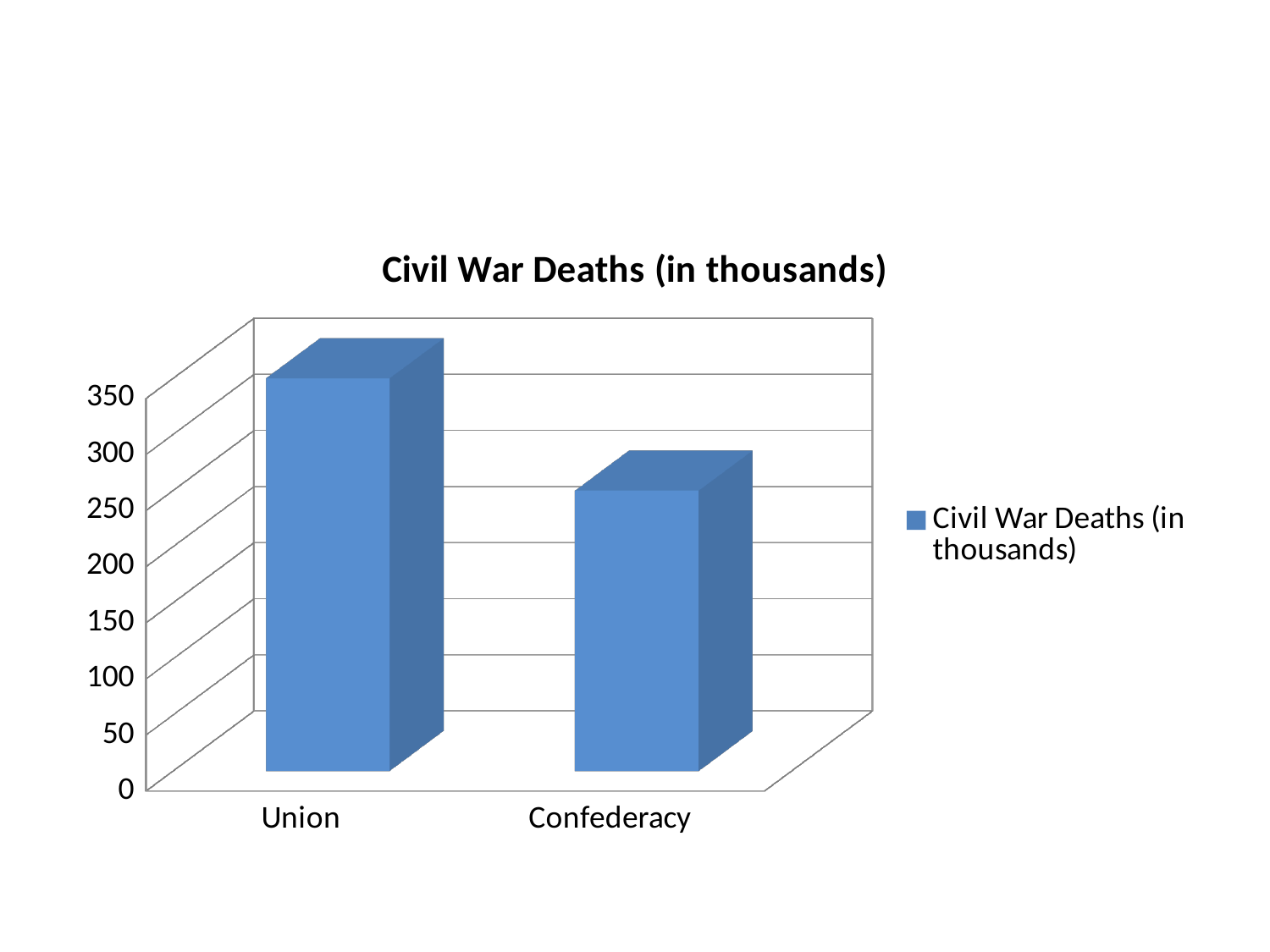
Which is larger, the value for Union or the value for Confederacy? Union How many categories are plotted on the x axis of the chart? 2 How many series does the legend list? 1 Which category has the lowest value in the chart? Confederacy Is the value for Confederacy greater or less than 200? greater Which category has the highest value in the chart? Union What is the title of the chart? Civil War Deaths (in thousands) What kind of chart is shown on the slide? Bar chart Is the value for Confederacy greater or less than 300? less Is the value for Union greater or less than 300? greater What is the name of the series listed in the legend? Civil War Deaths (in thousands)